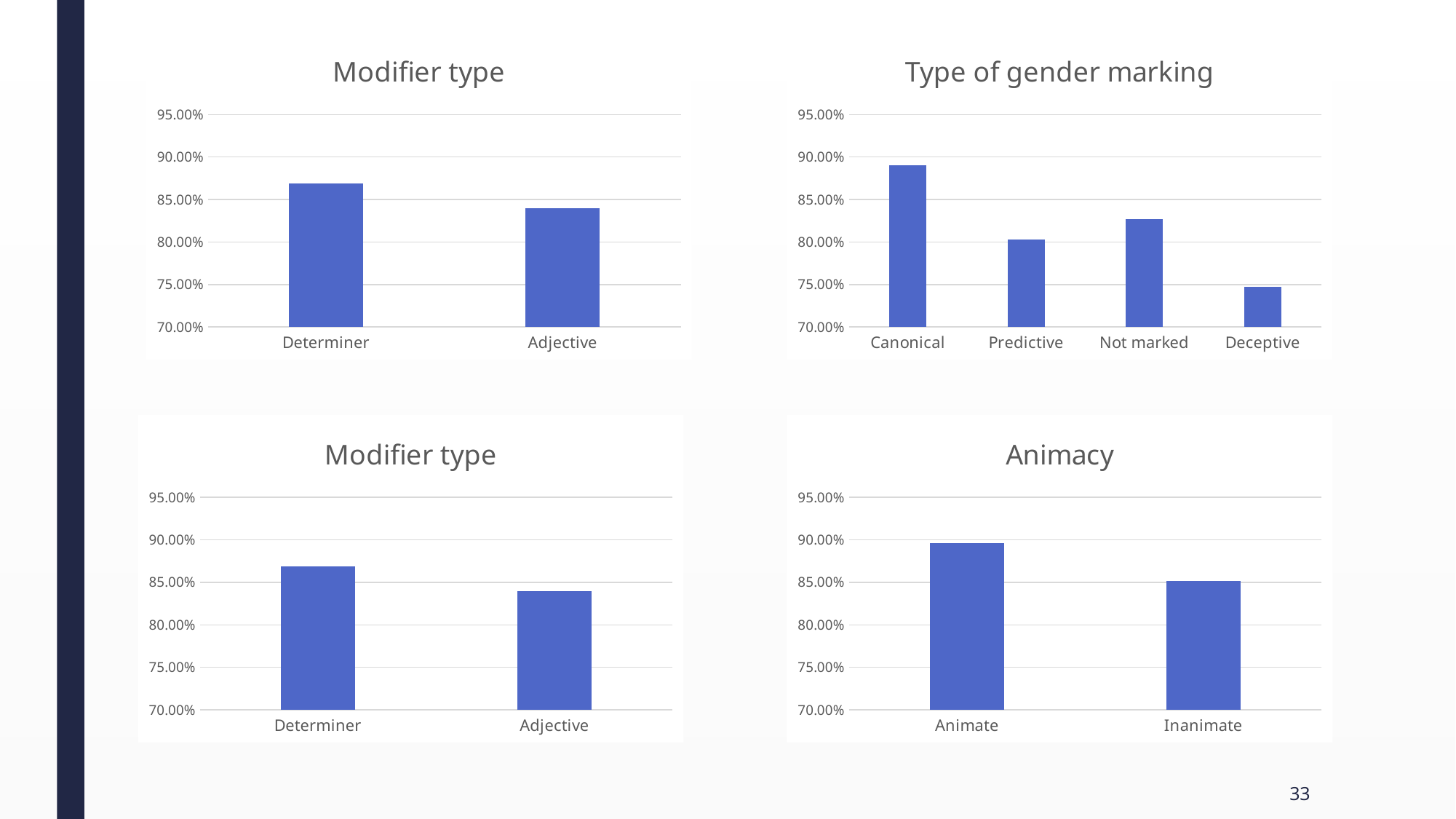
In the 'Type of gender marking' chart, which category has the lowest value? Deceptive What kind of chart is the 'Animacy' chart? bar chart In the 'Type of gender marking' chart, is the value for Deceptive greater or less than 80.00%? less In the 'Type of gender marking' chart, is the value for Canonical greater or less than 85.00%? greater In the 'Type of gender marking' chart, which is larger, Not marked or Predictive? Not marked In the 'Animacy' chart, which category has the higher value? Animate In the 'Animacy' chart, is the value for Animate greater or less than 85.00%? greater How many categories are shown in the 'Type of gender marking' chart? 4 In the 'Type of gender marking' chart, which category has the highest value? Canonical In the top-left 'Modifier type' chart, which category has the higher value? Determiner